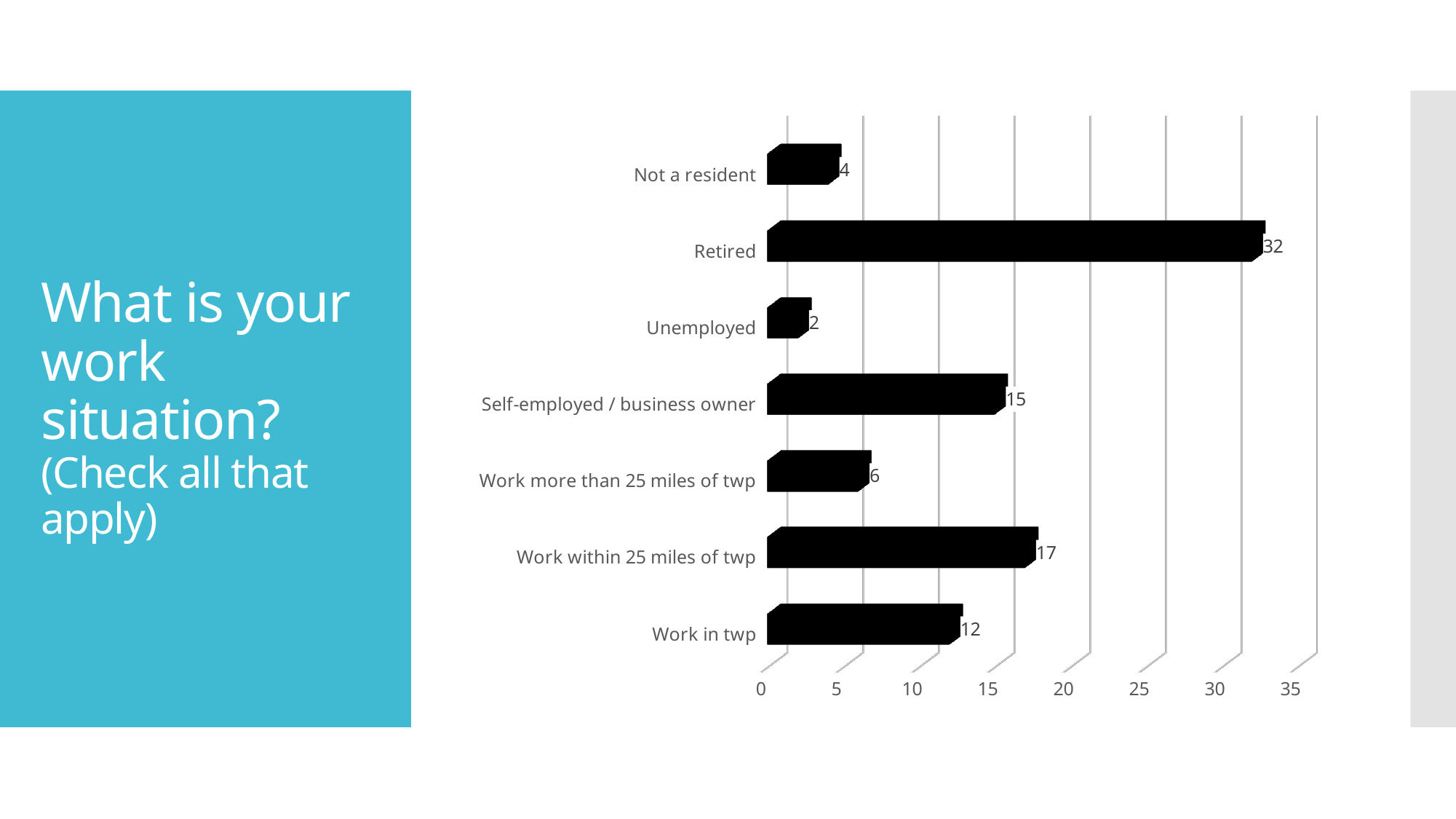
What is the value for Work within 25 miles of twp? 17 Which is larger, the value for Work in twp or the value for Not a resident? Work in twp Is the value for Retired greater or less than 30? greater What is the value for Retired? 32 What is the difference between the values for Work within 25 miles of twp and Work more than 25 miles of twp? 11 What is the value for Unemployed? 2 How many categories are shown in the chart? 7 Which category has the highest value? Retired Which category has the lowest value? Unemployed What is the difference between the values for Retired and Work in twp? 20 What is the value for Self-employed / business owner? 15 What kind of chart is shown on the slide? Bar chart